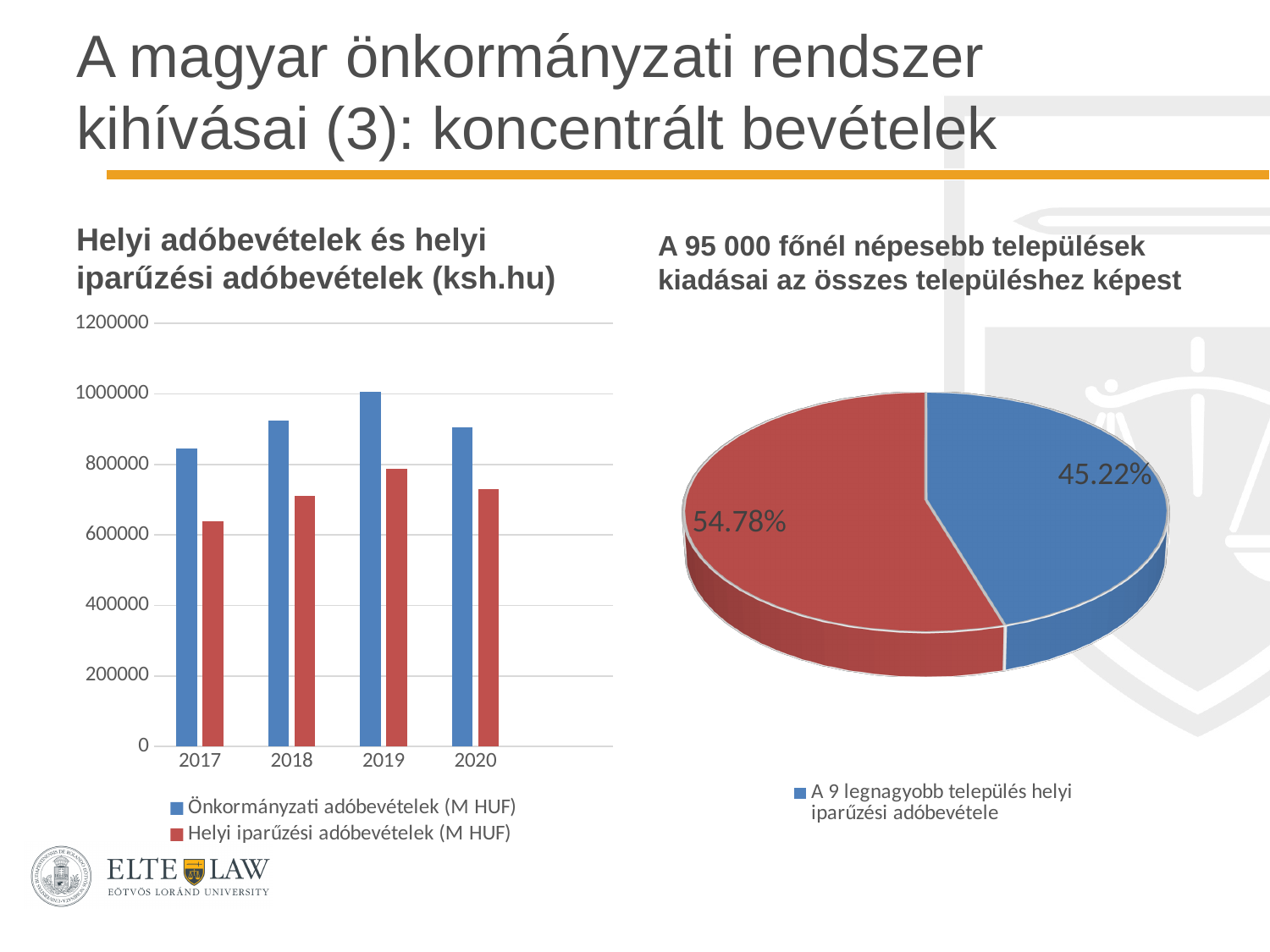
In the left bar chart, which series has the larger value in 2019: Önkormányzati adóbevételek (M HUF) or Helyi iparűzési adóbevételek (M HUF)? Önkormányzati adóbevételek (M HUF) What kind of chart is the right chart titled "A 95 000 főnél népesebb települések kiadásai az összes településhez képest"? Pie chart In the left bar chart, which year has the lowest value for Helyi iparűzési adóbevételek (M HUF)? 2017 In the left bar chart, how many years are shown on the x axis? 4 In the right pie chart, what share is shown for the blue slice, A 9 legnagyobb település helyi iparűzési adóbevétele? 45.22% In the right pie chart, what is the share of the larger (red) slice? 54.78% In the left bar chart, how many series does the legend list? 2 What kind of chart is the left chart titled "Helyi adóbevételek és helyi iparűzési adóbevételek (ksh.hu)"? Bar chart In the left bar chart, is the value for Helyi iparűzési adóbevételek (M HUF) in 2017 greater or less than 800000? less In the left bar chart, is the value for Önkormányzati adóbevételek (M HUF) in 2017 greater or less than 800000? greater In the left bar chart, do the values for Önkormányzati adóbevételek (M HUF) rise or fall from 2017 to 2019? Rise In the left bar chart, which year has the highest value for Önkormányzati adóbevételek (M HUF)? 2019